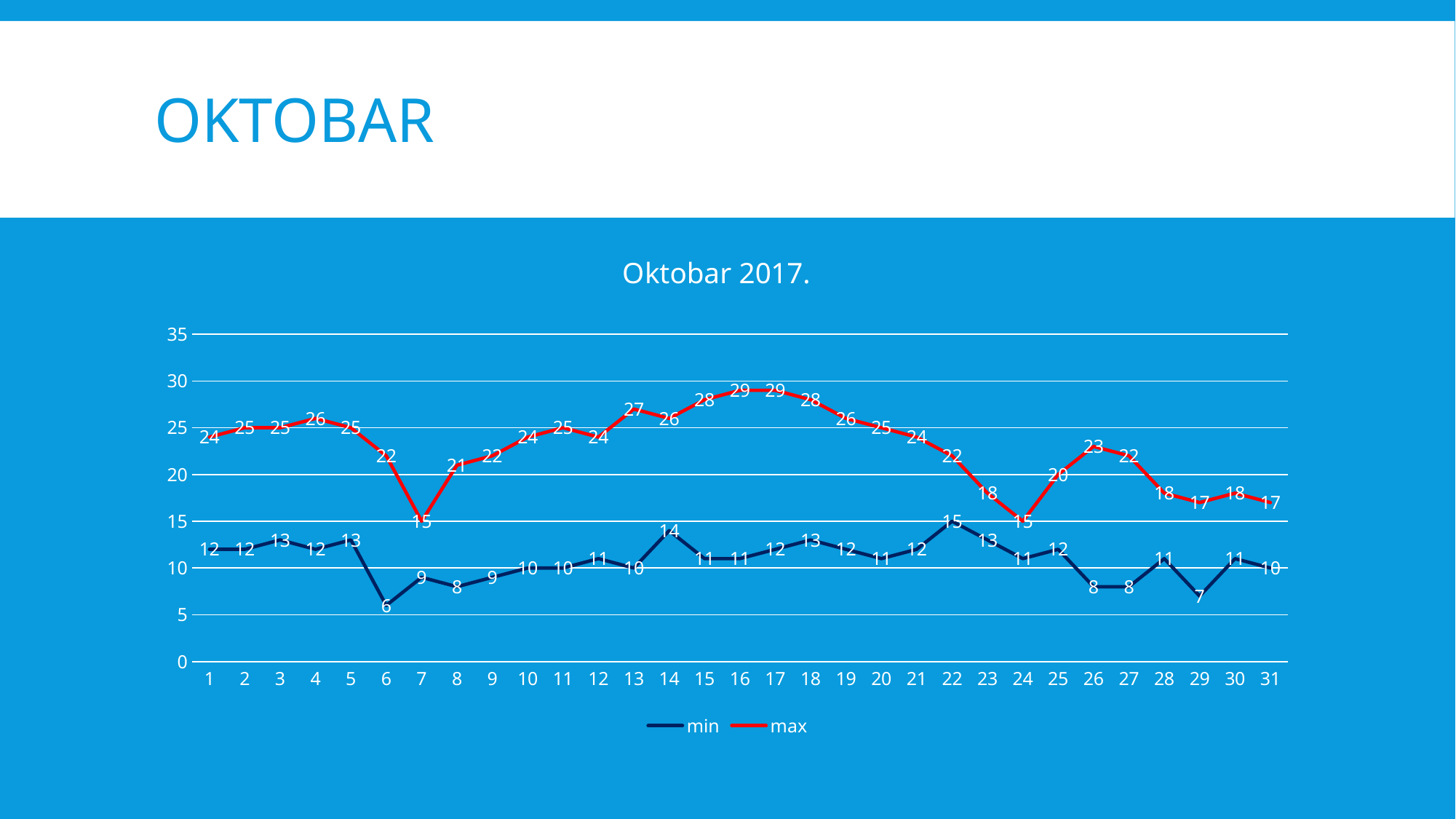
How many days are plotted on the x axis? 31 On which day is the min series at its lowest? 6 What is the max value on day 24? 15 What is the title of the chart? Oktobar 2017. What is the min value on day 6? 6 How many series does the legend list? 2 What is the min value on day 31? 10 What is the max value on day 16? 29 What is the difference between the max and min values on day 17? 17 On which day is the min series at its highest? 22 Which is larger, the max value on day 4 or the max value on day 7? day 4 What kind of chart is shown? line chart